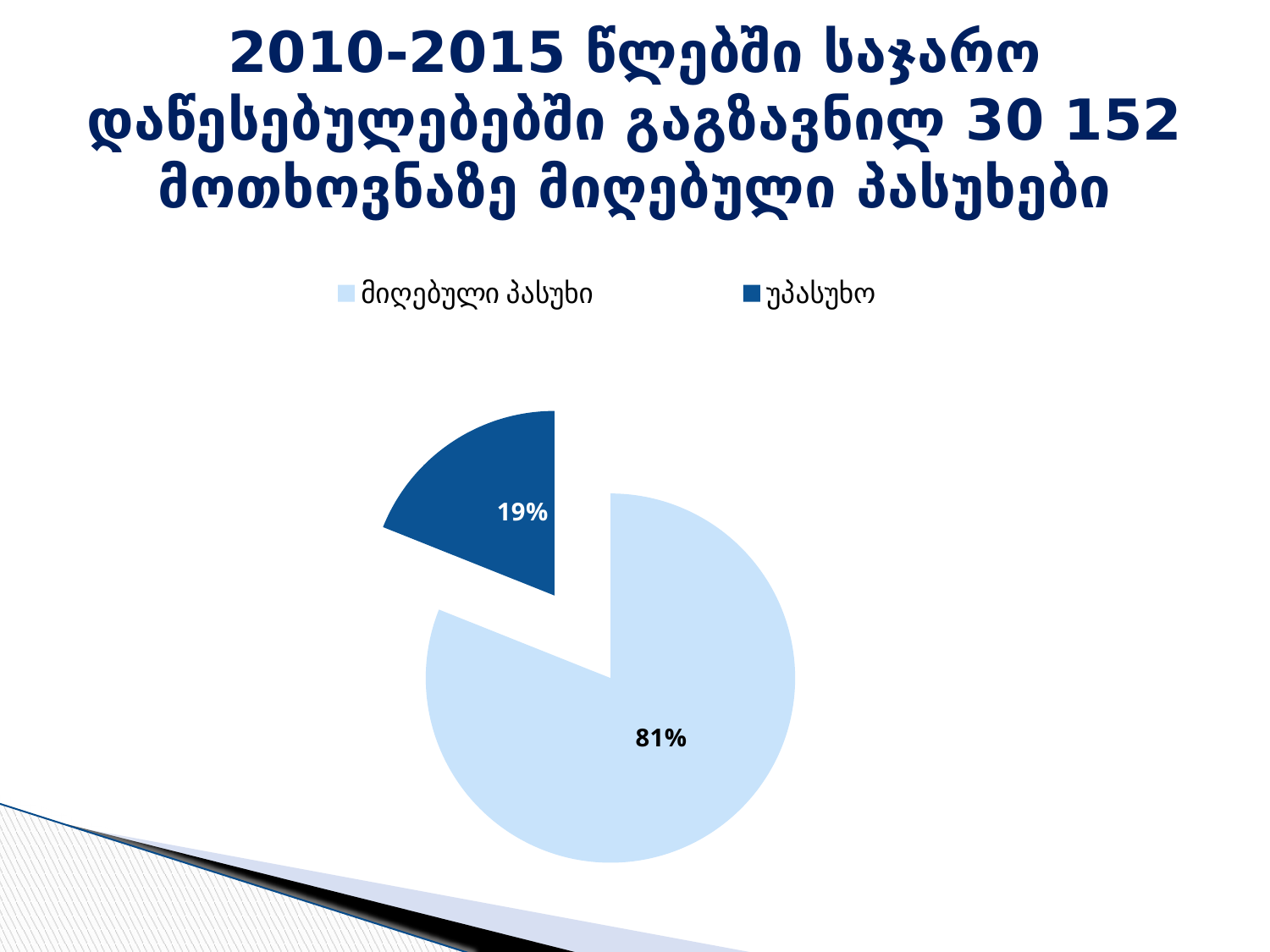
What colour is the "უპასუხო" slice in the pie chart? dark blue How many slices does the pie chart have? 2 What is the difference in percentage points between the "მიღებული პასუხი" slice and the "უპასუხო" slice? 62 percentage points What share of the pie does the "უპასუხო" slice represent? 19% What kind of chart is shown on the slide? pie chart What number of requests is mentioned in the chart title? 30 152 Which slice of the pie is the smallest? უპასუხო Which slice of the pie is the largest? მიღებული პასუხი What share of the pie does the "მიღებული პასუხი" slice represent? 81% Which is larger, the "მიღებული პასუხი" slice or the "უპასუხო" slice? მიღებული პასუხი How many entries does the legend list? 2